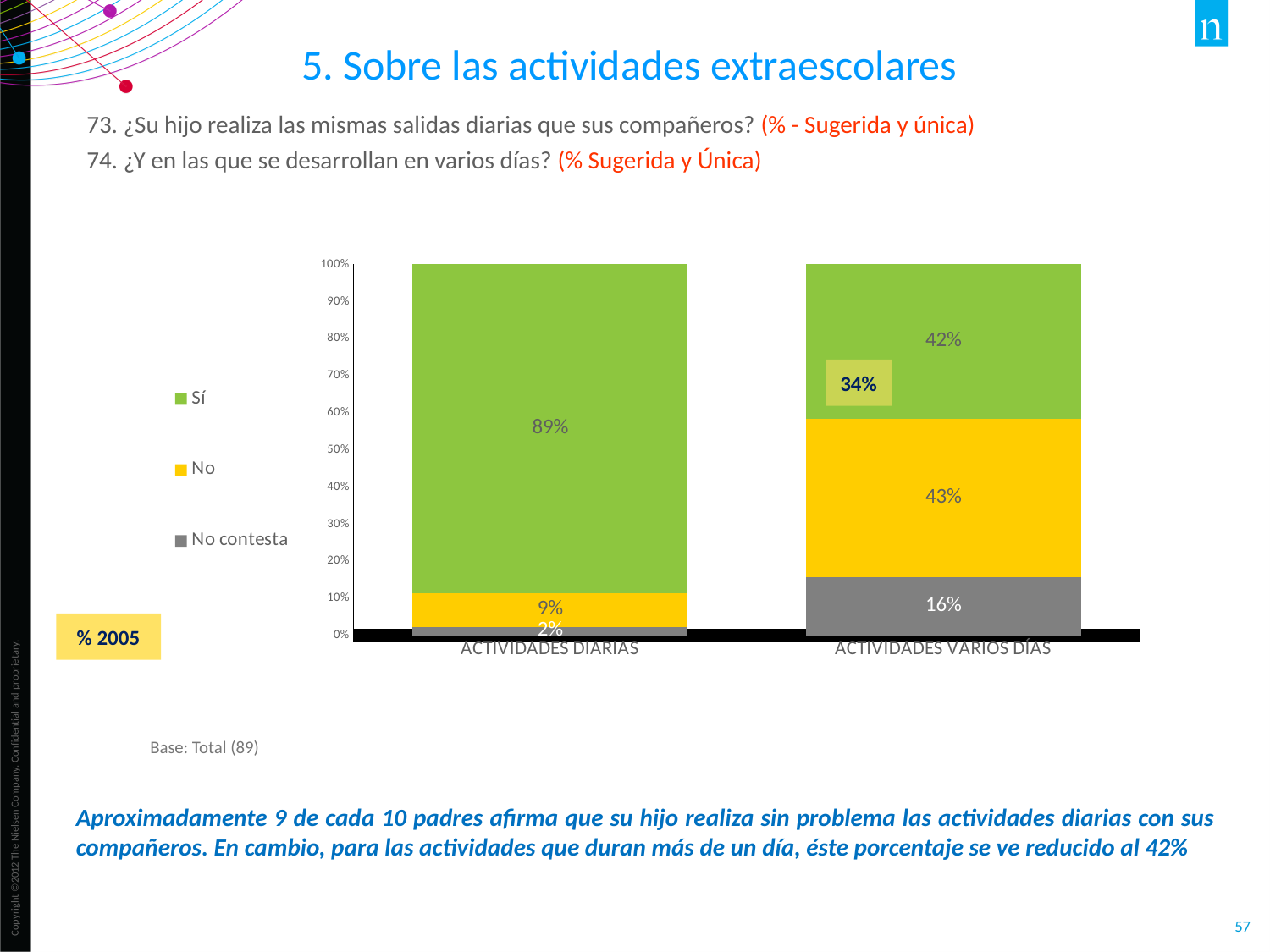
What is the difference between the "No contesta" values for ACTIVIDADES VARIOS DÍAS and ACTIVIDADES DIARIAS? 14% What is the "No contesta" value for ACTIVIDADES VARIOS DÍAS? 16% How many categories are shown on the x axis? 2 What kind of chart is shown on the slide? Stacked bar chart What percentage of parents answered "No" for ACTIVIDADES VARIOS DÍAS? 43% What is the "No" value for ACTIVIDADES DIARIAS? 9% Which colour represents the "No" series in the legend? Yellow Which category has the higher "Sí" value, ACTIVIDADES DIARIAS or ACTIVIDADES VARIOS DÍAS? ACTIVIDADES DIARIAS How many series does the legend list? 3 What is the "Sí" value for ACTIVIDADES VARIOS DÍAS? 42% What percentage of parents answered "Sí" for ACTIVIDADES DIARIAS? 89% What is the difference between the "Sí" values for ACTIVIDADES DIARIAS and ACTIVIDADES VARIOS DÍAS? 47%